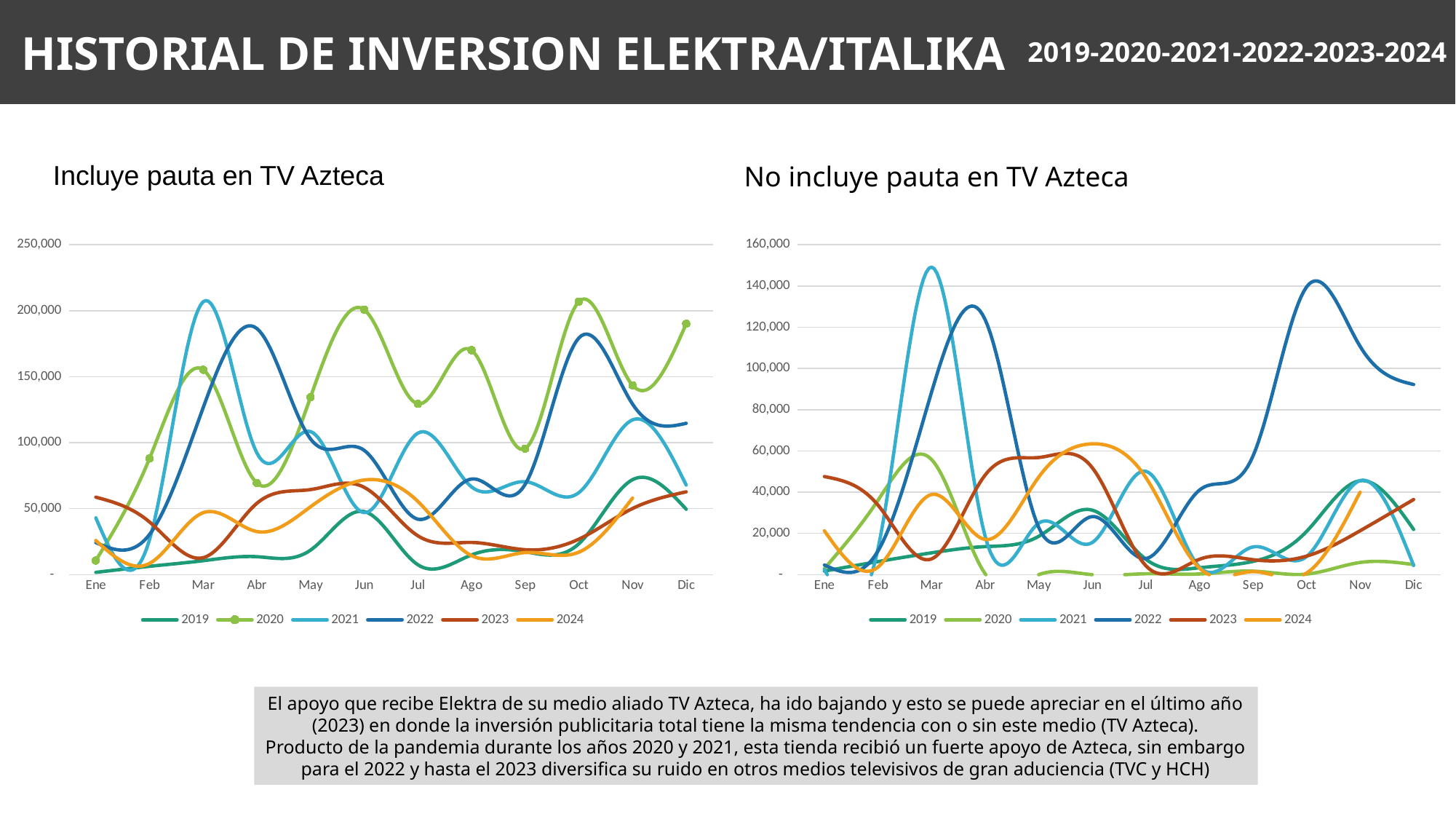
In the 'Incluye pauta en TV Azteca' chart, is the value for 2020 in Jun greater or less than 150,000? greater In the 'Incluye pauta en TV Azteca' chart, in which month does the 2021 series reach its highest value? Mar In the 'No incluye pauta en TV Azteca' chart, in which month does the 2021 series reach its highest value? Mar In the 'Incluye pauta en TV Azteca' chart, is the value for 2019 in Oct greater or less than 100,000? less How many months are shown on the x axis of the 'Incluye pauta en TV Azteca' chart? 12 What is the title of the chart on the right side of the slide? No incluye pauta en TV Azteca What kind of chart is the 'Incluye pauta en TV Azteca' chart? Line chart In the 'No incluye pauta en TV Azteca' chart, is the value for 2022 in Oct greater or less than 120,000? greater In the 'No incluye pauta en TV Azteca' chart, in which month does the 2022 series reach its highest value? Oct In the 'Incluye pauta en TV Azteca' chart, which is larger: the 2021 value in Mar or the 2022 value in Abr? 2021 in Mar How many series does the legend of the 'No incluye pauta en TV Azteca' chart list? 6